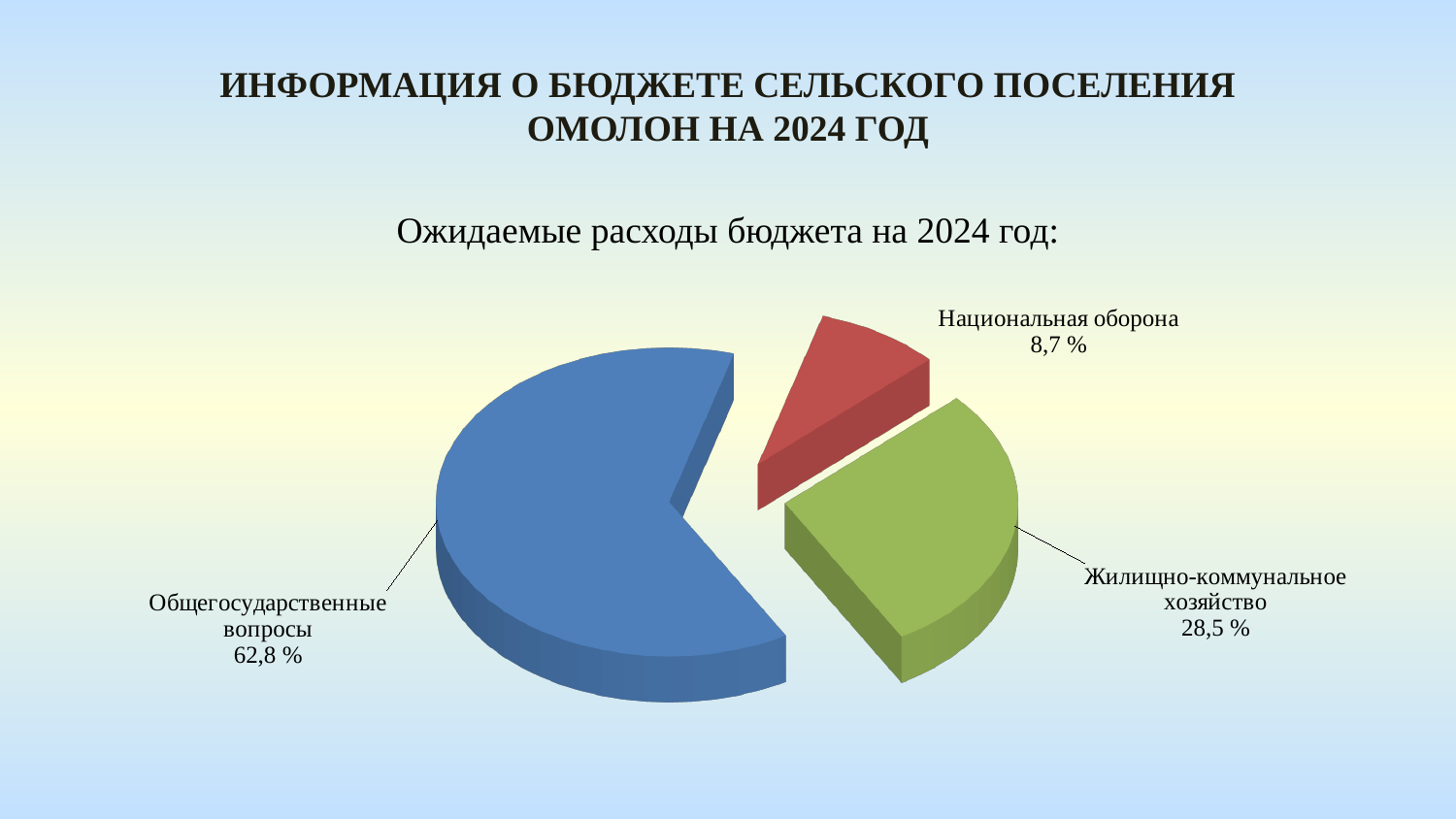
What share of expected 2024 budget expenditures goes to Национальная оборона? 8,7 % What is the difference in percentage points between Жилищно-коммунальное хозяйство and Национальная оборона? 19,8 Which expenditure category has the smallest share of the pie? Национальная оборона What is the title of the chart on the slide? Ожидаемые расходы бюджета на 2024 год: What share of expected 2024 budget expenditures goes to Общегосударственные вопросы? 62,8 % What share of expected 2024 budget expenditures goes to Жилищно-коммунальное хозяйство? 28,5 % How many expenditure categories are shown in the pie chart? 3 What colour is the slice for Национальная оборона? Red Which is larger: the share for Жилищно-коммунальное хозяйство or for Национальная оборона? Жилищно-коммунальное хозяйство Which expenditure category has the largest share of the pie? Общегосударственные вопросы What is the difference in percentage points between Общегосударственные вопросы and Жилищно-коммунальное хозяйство? 34,3 What kind of chart is shown on the slide? Pie chart